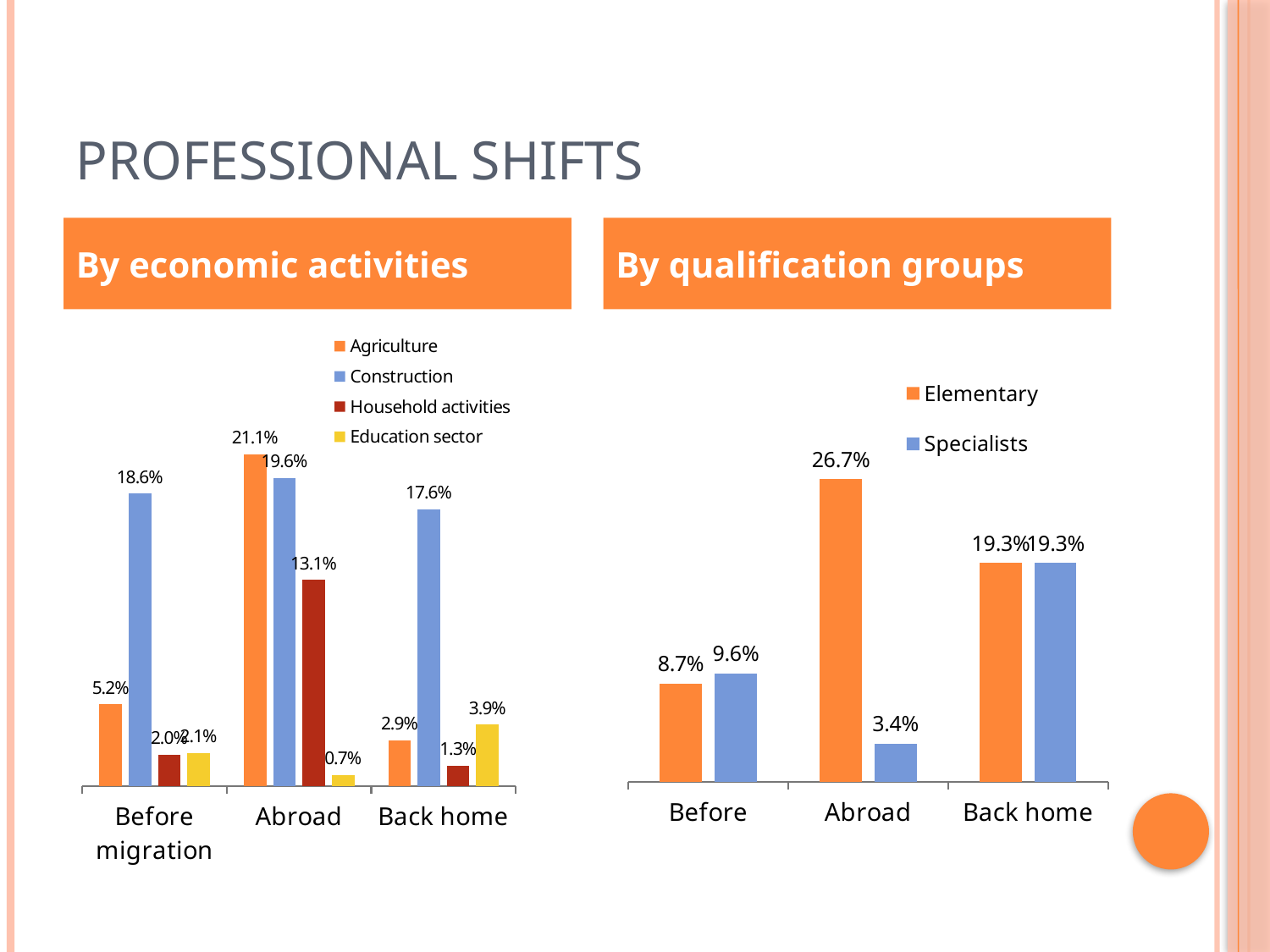
In the 'By economic activities' chart, what is the value for Construction in the Abroad category? 19.6% In the 'By qualification groups' chart, which is larger in the Abroad category, Elementary or Specialists? Elementary What kind of chart is the 'By qualification groups' chart? Bar chart In the 'By economic activities' chart, which series has the highest value in the Back home category? Construction In the 'By qualification groups' chart, what is the value for Elementary in the Abroad category? 26.7% In the 'By qualification groups' chart, how many categories are shown on the x axis? 3 In the 'By qualification groups' chart, what is the difference between Elementary and Specialists in the Abroad category? 23.3% In the 'By economic activities' chart, what is the difference between Agriculture Abroad and Agriculture Back home? 18.2% In the 'By qualification groups' chart, what is the value for Specialists in the Before category? 9.6% In the 'By economic activities' chart, which series has the lowest value in the Abroad category? Education sector In the 'By economic activities' chart, what is the value for Household activities in the Abroad category? 13.1% In the 'By economic activities' chart, how many series does the legend list? 4